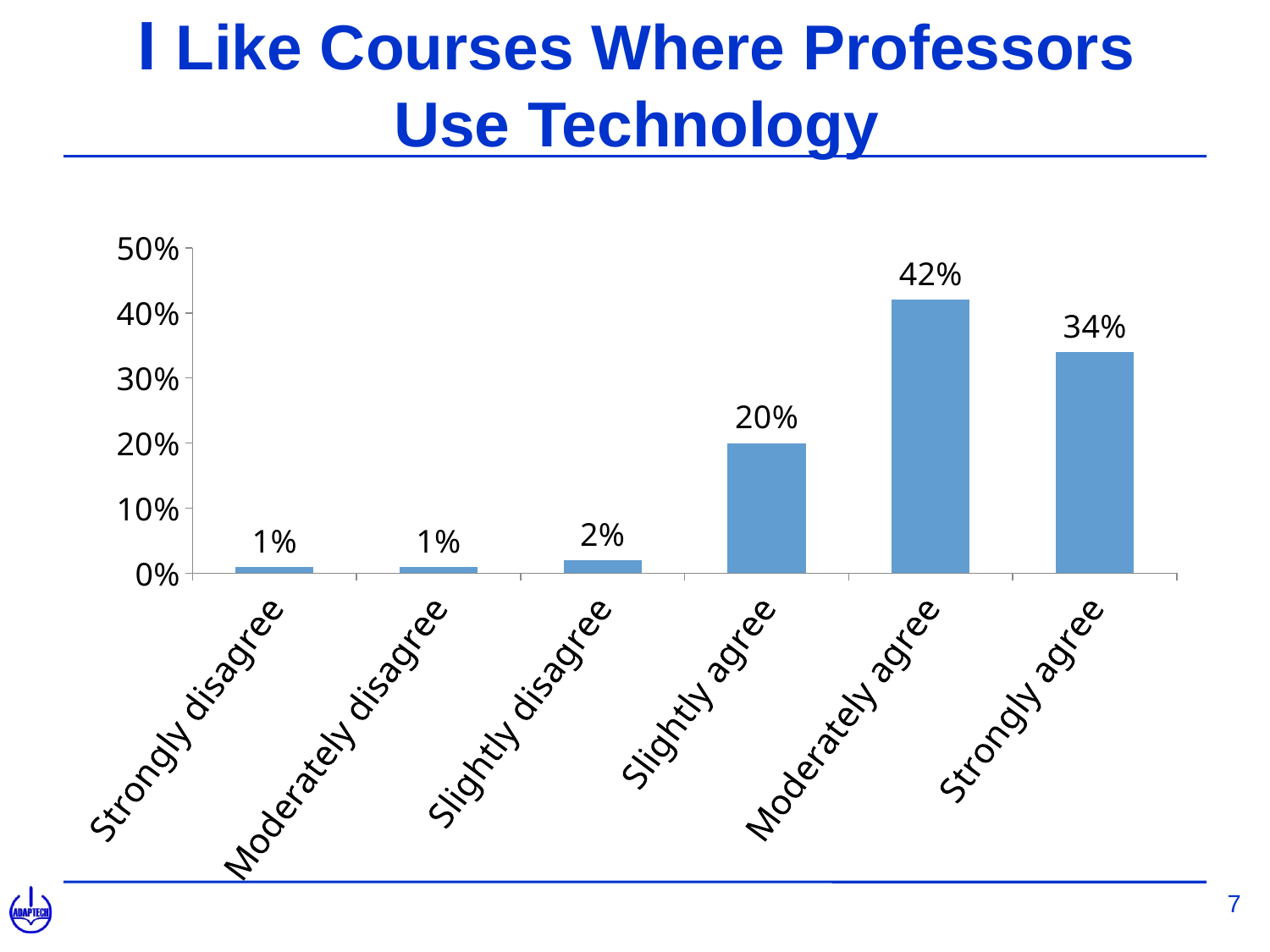
What is the difference between the values for Moderately agree and Strongly agree? 8% What is the value for Strongly agree? 34% How many categories are shown on the x axis? 6 What kind of chart is shown on the slide? bar chart What is the value for Moderately agree? 42% Do the values generally rise or fall from Strongly disagree to Moderately agree? rise What is the title of the slide? I Like Courses Where Professors Use Technology What is the value for Slightly disagree? 2% Which category has the highest value? Moderately agree What is the value for Slightly agree? 20% Which is larger, the value for Slightly agree or the value for Strongly agree? Strongly agree Is the value for Moderately agree greater or less than 40%? greater